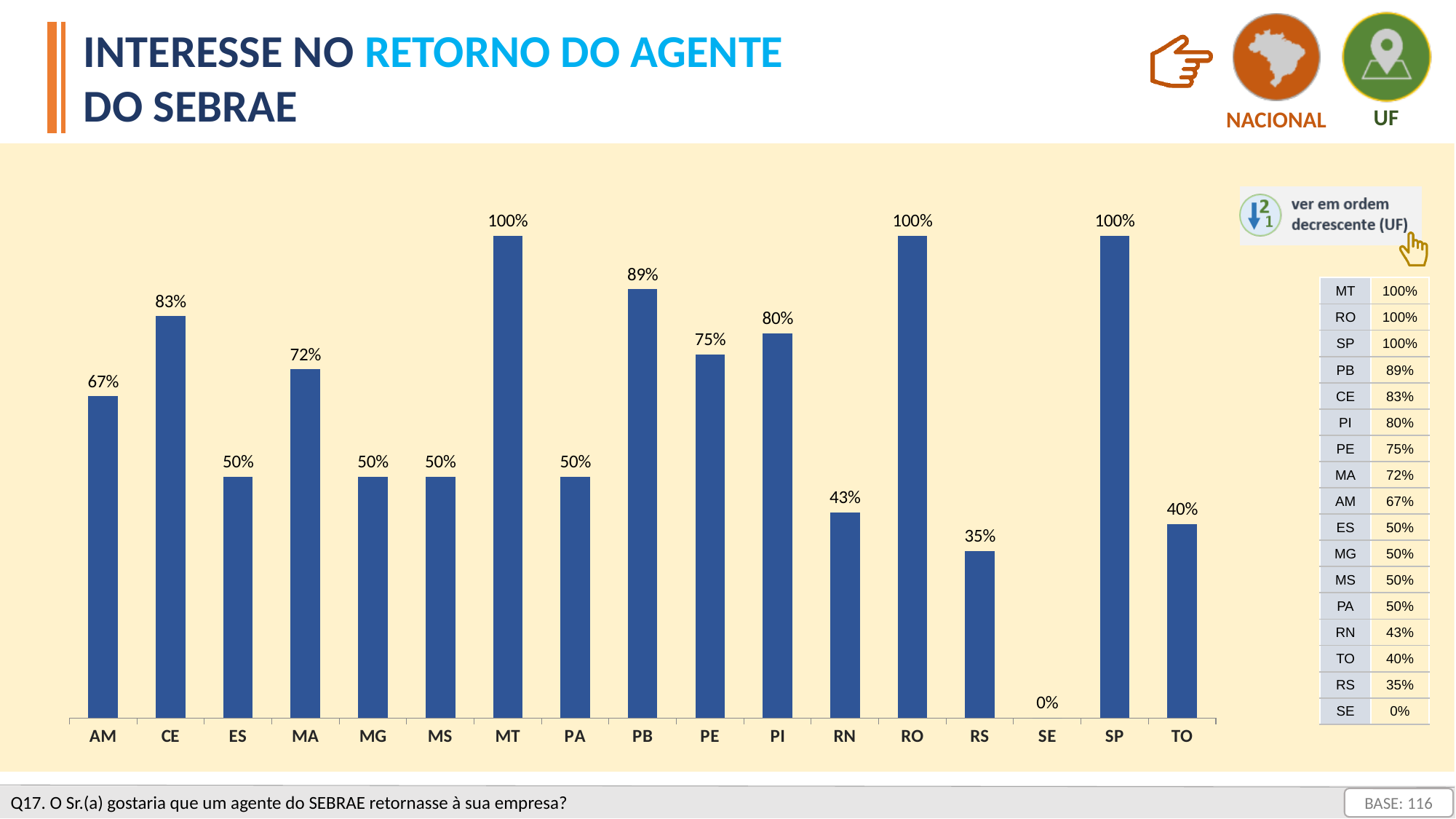
What is the value for RN? 43% What is the difference between the values for PI and PE? 5% Which categories share the highest value of 100%? MT, RO and SP What kind of chart is shown on the slide? Bar chart How many categories have a value of exactly 50%? 4 Which category has the lowest value? SE Which is larger, the value for AM or the value for MA? MA What is the difference between the values for MA and RS? 37% How many categories are shown on the x axis? 17 What is the value for PB? 89% What is the value for CE? 83% What is the value for TO? 40%